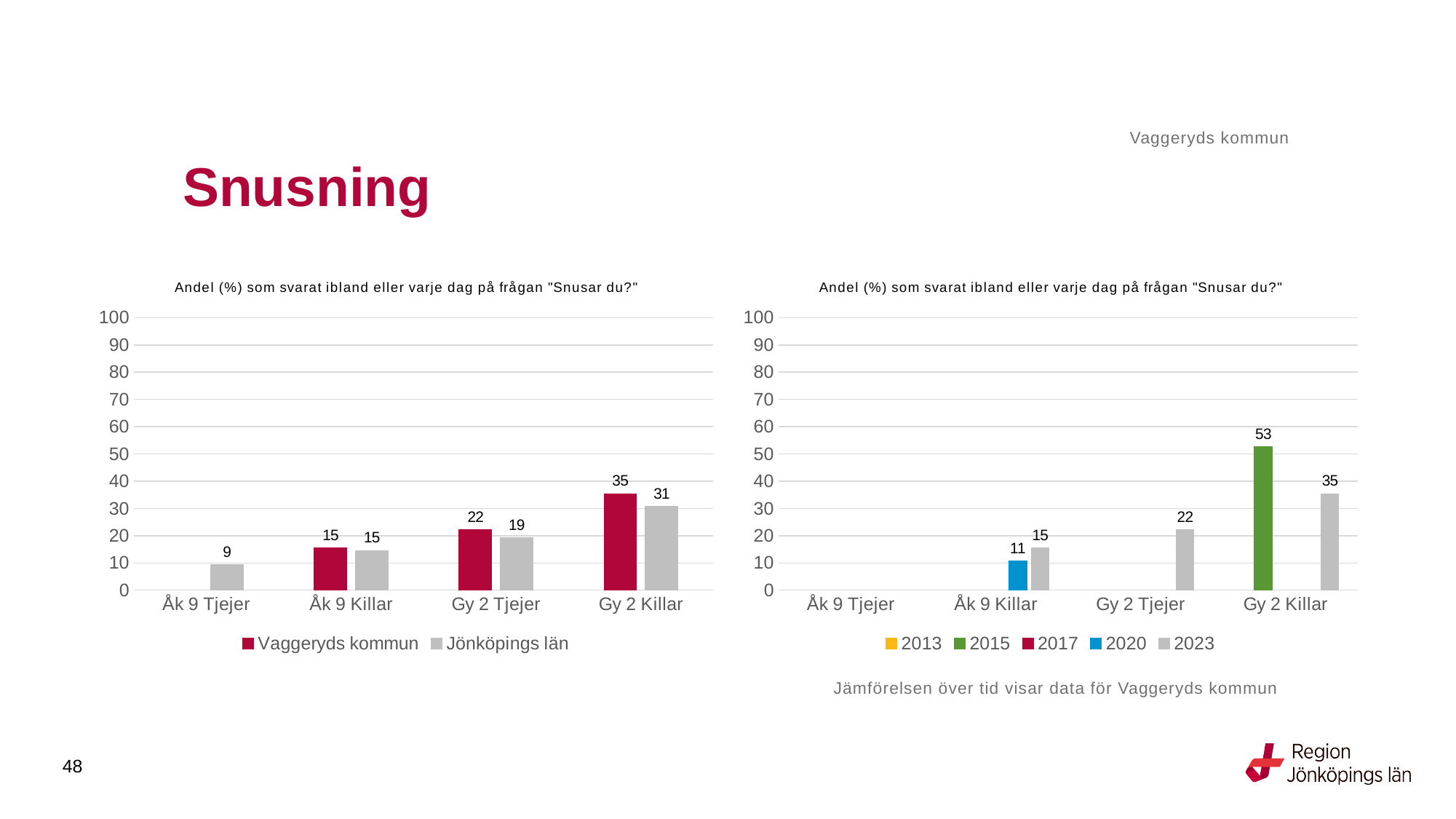
In the right chart, what is the difference between the 2015 and 2023 values for Gy 2 Killar? 18 In the right chart, what is the value for 2015 for Gy 2 Killar? 53 In the right chart, what is the value for 2020 for Åk 9 Killar? 11 In the left chart, which category has the highest value for Jönköpings län? Gy 2 Killar In the left chart, what is the value for Jönköpings län for Åk 9 Tjejer? 9 What type of chart is the right chart? Bar chart In the left chart, what is the value for Jönköpings län for Gy 2 Tjejer? 19 In the left chart, is the value for Vaggeryds kommun for Gy 2 Tjejer greater or less than 20? greater In the left chart, what is the value for Vaggeryds kommun for Gy 2 Killar? 35 In the left chart, what is the difference between Vaggeryds kommun and Jönköpings län for Gy 2 Killar? 4 In the right chart, how many series does the legend list? 5 In the left chart, how many series does the legend list? 2